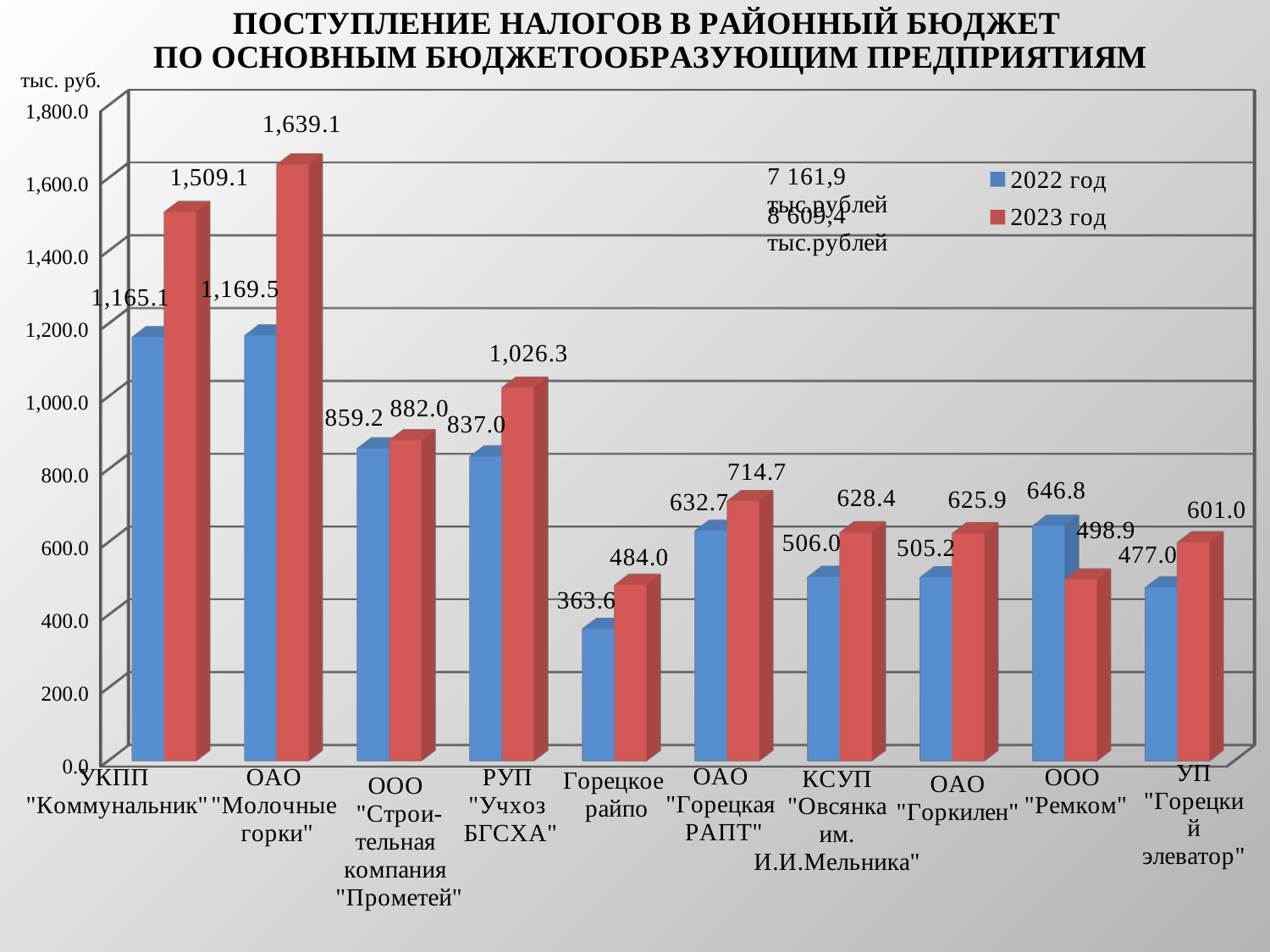
What kind of chart is shown on the slide? Bar chart What is the 2023 год value for ОАО "Молочные горки"? 1,639.1 Which enterprise has the lowest 2022 год value? Горецкое райпо How many series does the legend list? 2 What is the difference between the 2023 год and 2022 год values for УКПП "Коммунальник"? 344.0 What is the 2022 год value for Горецкое райпо? 363.6 For ООО "Ремком", which is larger: the 2022 год value or the 2023 год value? 2022 год How many enterprises are shown on the x axis? 10 What is the 2023 год value for РУП "Учхоз БГСХА"? 1,026.3 Which is larger: the 2023 год value for ОАО "Горецкая РАПТ" or the 2023 год value for ОАО "Горкилен"? ОАО "Горецкая РАПТ" What unit is shown on the vertical axis label? тыс. руб. Which enterprise has the highest 2023 год value? ОАО "Молочные горки"